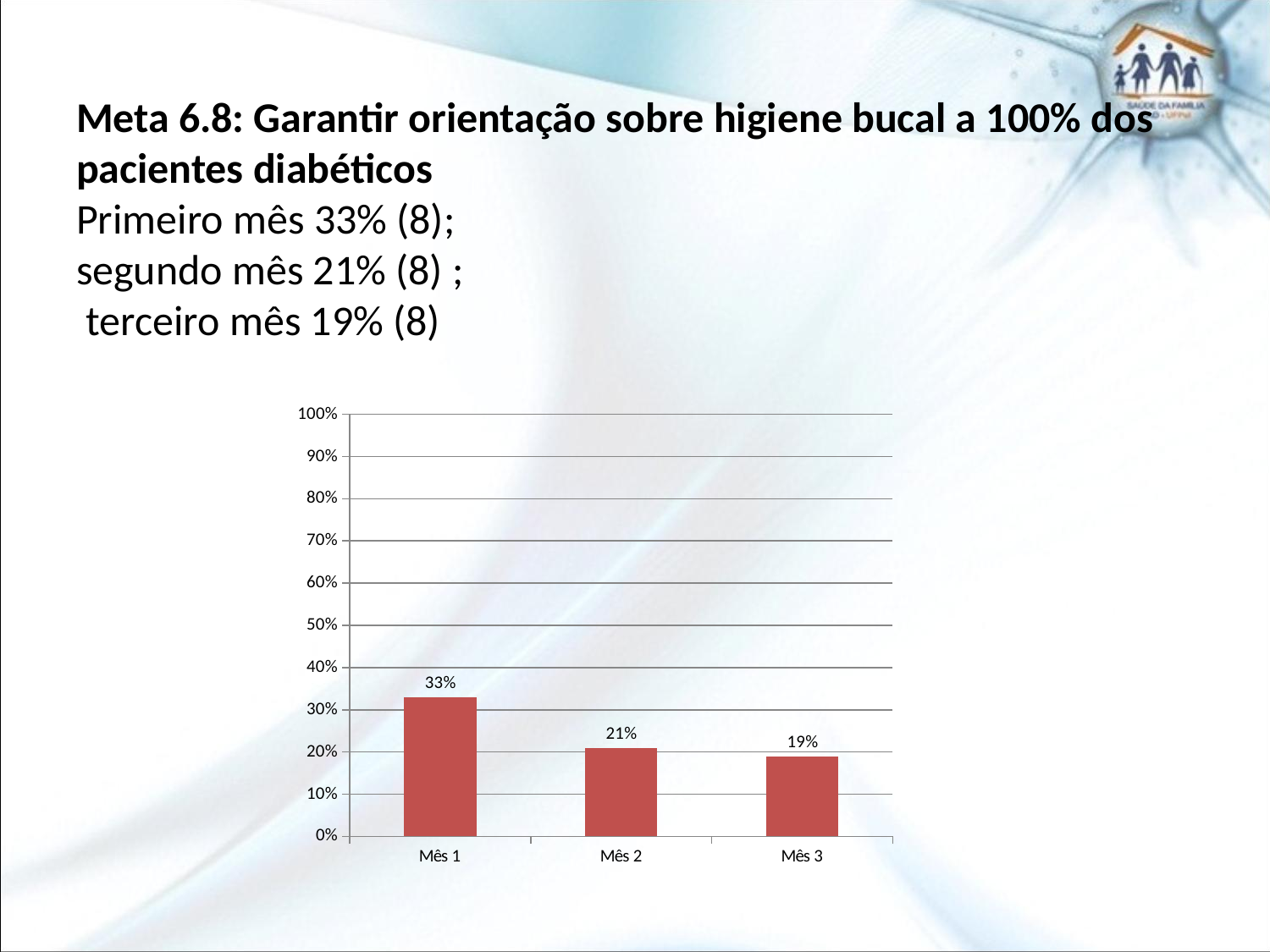
Do the values rise or fall from Mês 1 to Mês 3? fall What is the difference between the values for Mês 1 and Mês 2? 12% Which is larger, the value for Mês 1 or the value for Mês 3? Mês 1 Which month has the lowest value? Mês 3 Which month has the highest value? Mês 1 What is the value for Mês 2? 21% What is the value for Mês 3? 19% How many categories are shown on the x axis? 3 Is the value for Mês 1 greater or less than 30%? greater What is the difference between the values for Mês 2 and Mês 3? 2% What kind of chart is shown on the slide? bar chart What is the value for Mês 1? 33%